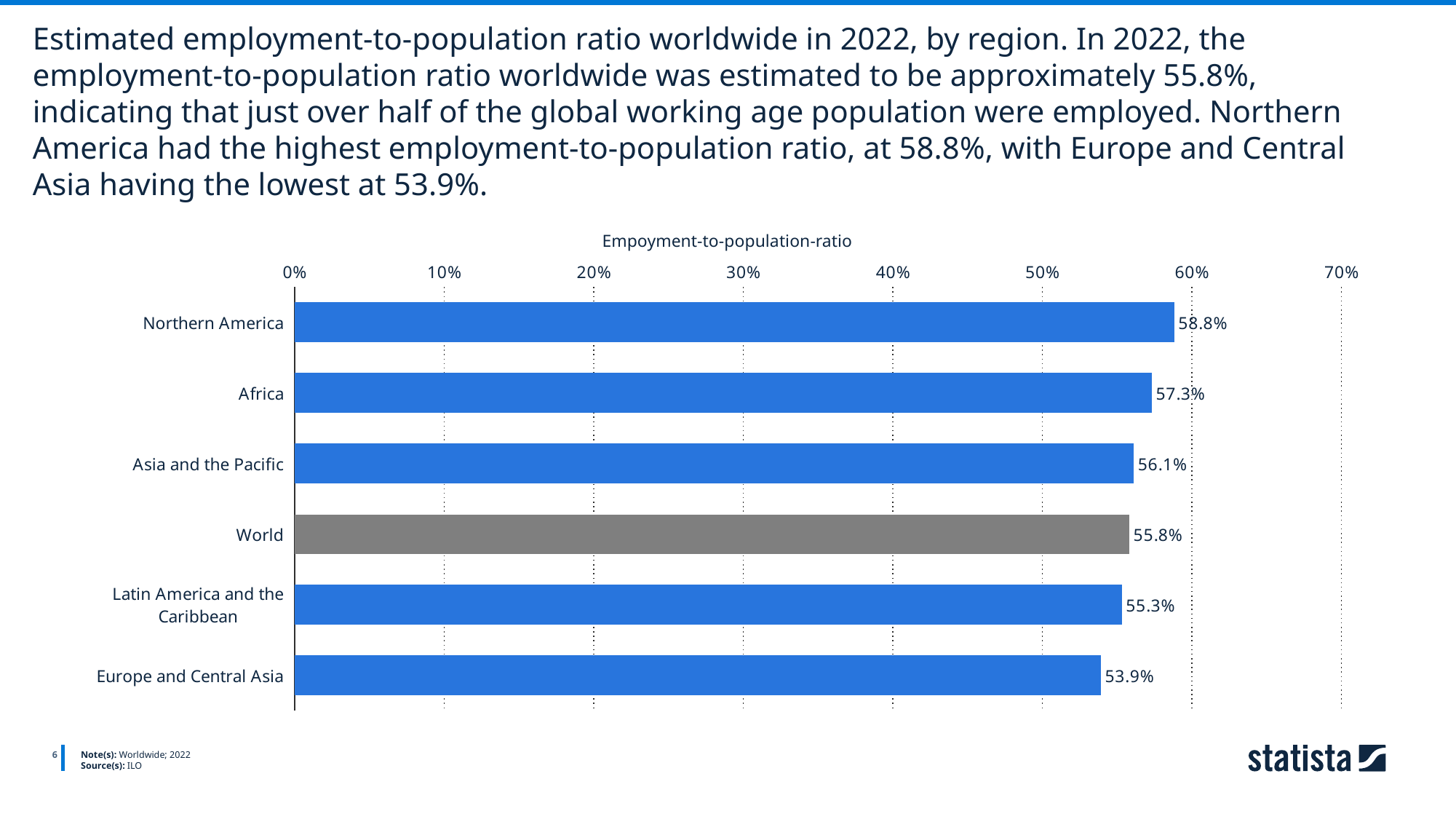
Which bar is coloured grey rather than blue? World What is the difference between the values for Africa and Asia and the Pacific? 1.2% What is the difference between the values for Northern America and Europe and Central Asia? 4.9% Which region has the lowest employment-to-population ratio? Europe and Central Asia Which has a higher employment-to-population ratio, Asia and the Pacific or Latin America and the Caribbean? Asia and the Pacific What is the value shown for World? 55.8% What is the employment-to-population ratio for Northern America? 58.8% How many bars are shown in the chart? 6 What is the employment-to-population ratio for Africa? 57.3% What type of chart is shown on the slide? Bar chart Which region has the highest employment-to-population ratio? Northern America What is the employment-to-population ratio for Latin America and the Caribbean? 55.3%